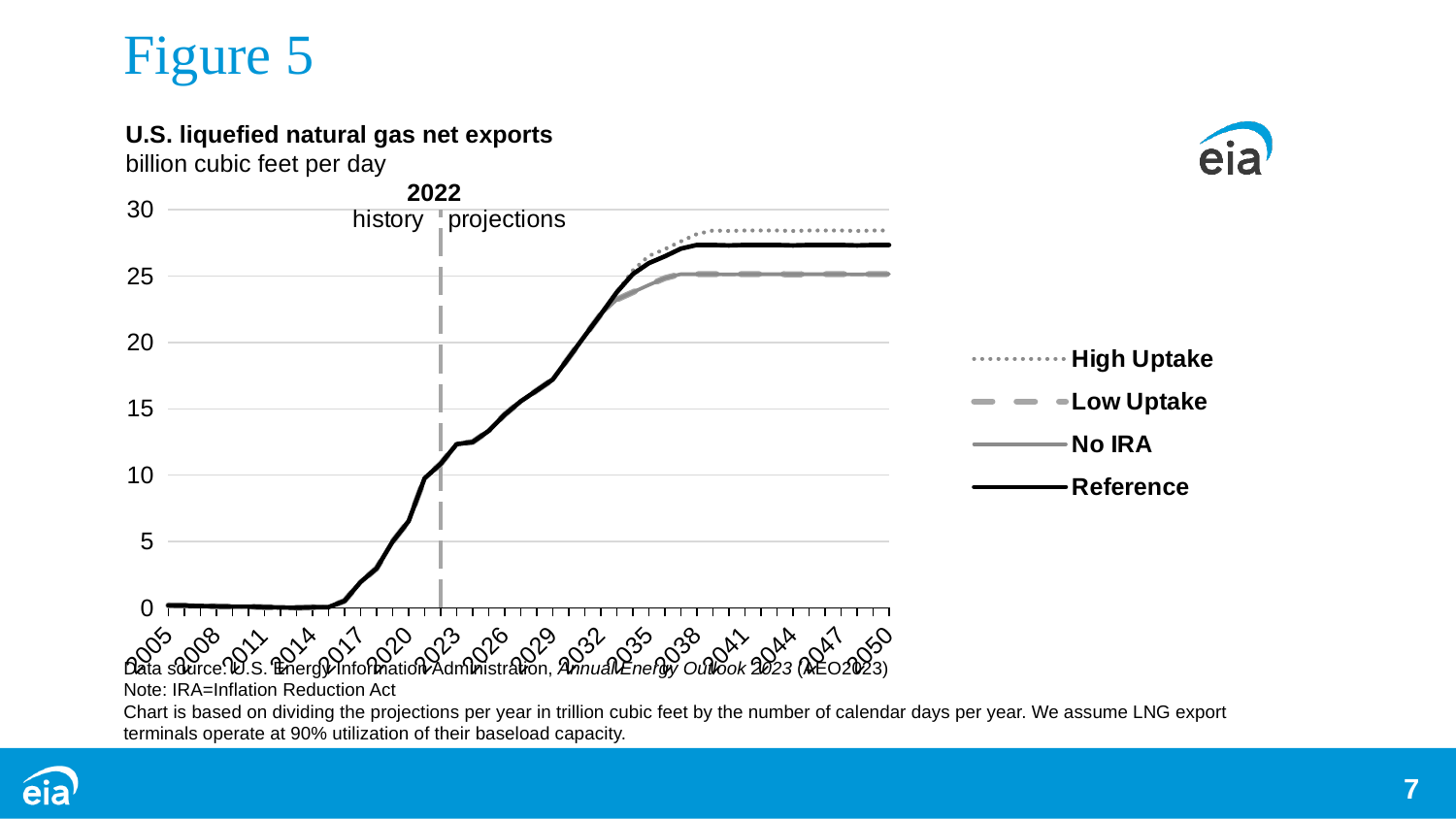
What kind of chart is shown on the slide? line chart Is the Reference value in 2029 greater or less than 15? greater Is the High Uptake value in 2050 greater or less than 30? less What unit is the y axis measured in? billion cubic feet per day In 2050, which is larger, the High Uptake value or the Low Uptake value? High Uptake How many series does the legend list? 4 What is the title of the chart? U.S. liquefied natural gas net exports Is the Reference value in 2050 greater or less than 25? greater Do the values generally rise or fall between 2014 and 2035? rise Which series has the highest value in 2050? High Uptake How many year labels are shown on the x axis? 16